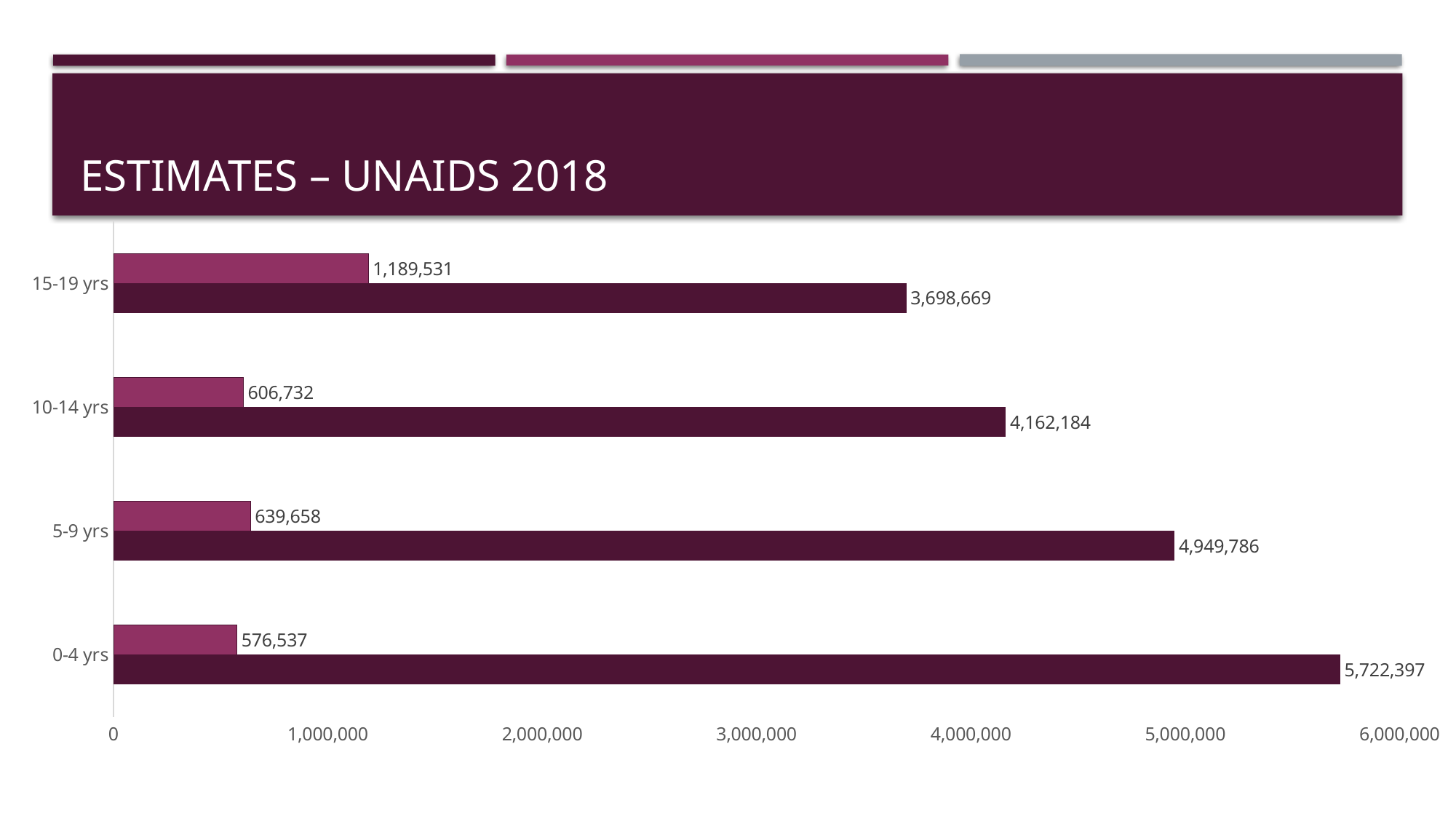
Which age group has the highest value among the dark bars? 0-4 yrs Which age group has the lowest value among the lighter magenta bars? 0-4 yrs Do the dark bar values rise or fall as the age group increases from 0-4 yrs to 15-19 yrs? fall What is the value of the dark bar for the 10-14 yrs age group? 4,162,184 What is the value of the dark bar for the 0-4 yrs age group? 5,722,397 What is the difference between the dark bar and the magenta bar for the 15-19 yrs age group? 2,509,138 What kind of chart is shown on the slide? bar chart What is the difference between the dark bar and the magenta bar for the 0-4 yrs age group? 5,145,860 What is the value of the lighter magenta bar for the 15-19 yrs age group? 1,189,531 Which is larger: the magenta bar for 5-9 yrs or the magenta bar for 10-14 yrs? 5-9 yrs Is the value of the dark bar for 15-19 yrs greater or less than 4,000,000? less How many age groups are shown on the chart? 4